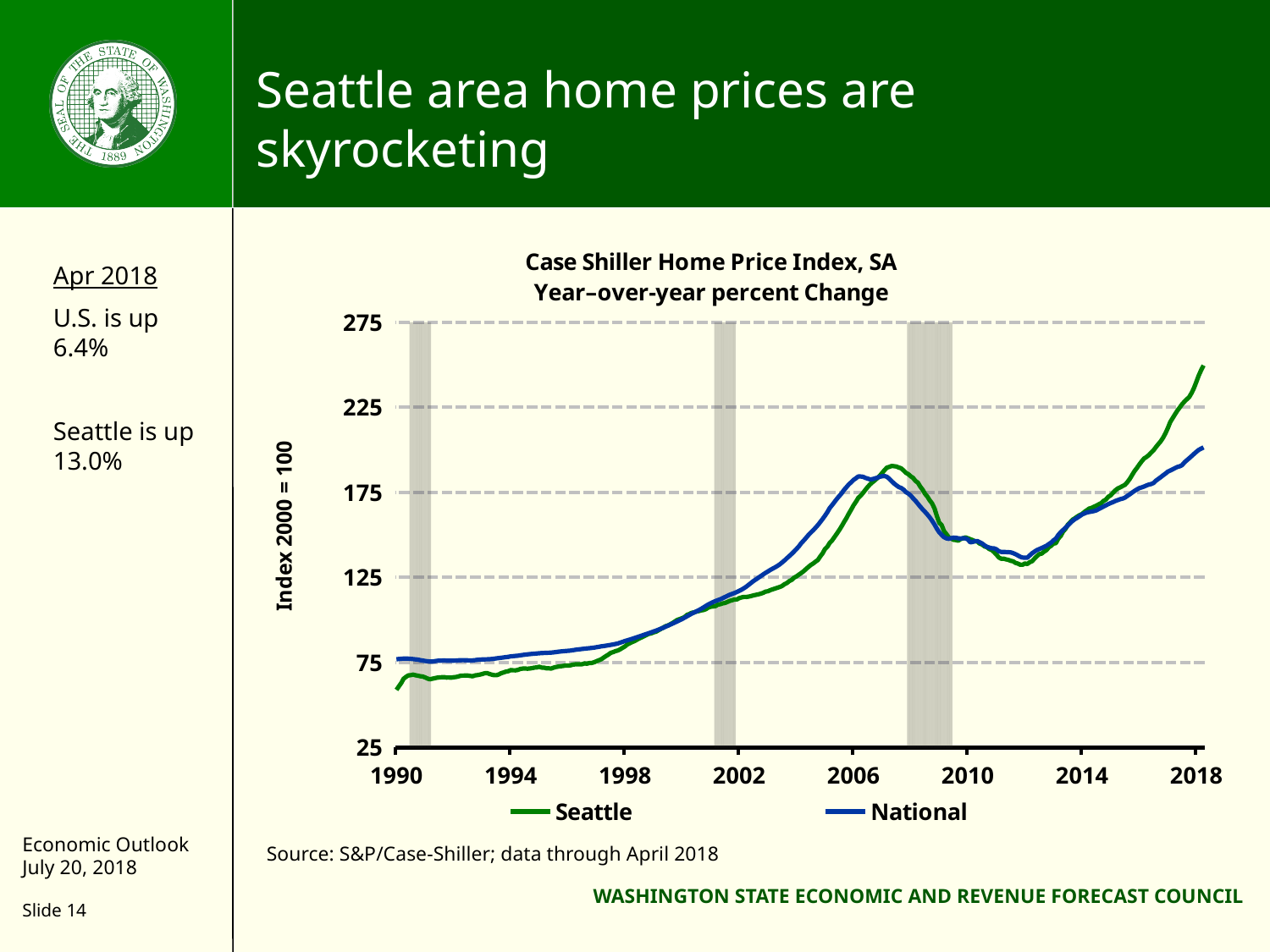
Is the value for National in 2018 greater or less than 225? less Does the Seattle series rise or fall between 2007 and 2012? fall Which series has the higher value in 2006, Seattle or National? National Is the value for Seattle in 1990 greater or less than 75? less Is the value for Seattle in 2018 greater or less than 225? greater Which series has the higher value in 2018, Seattle or National? Seattle What is the title of the chart? Case Shiller Home Price Index, SA Year-over-year percent Change What kind of chart is shown on the slide? line chart How many series does the legend list? 2 Does the Seattle series rise or fall between 2012 and 2018? rise What is the label on the vertical axis of the chart? Index 2000 = 100